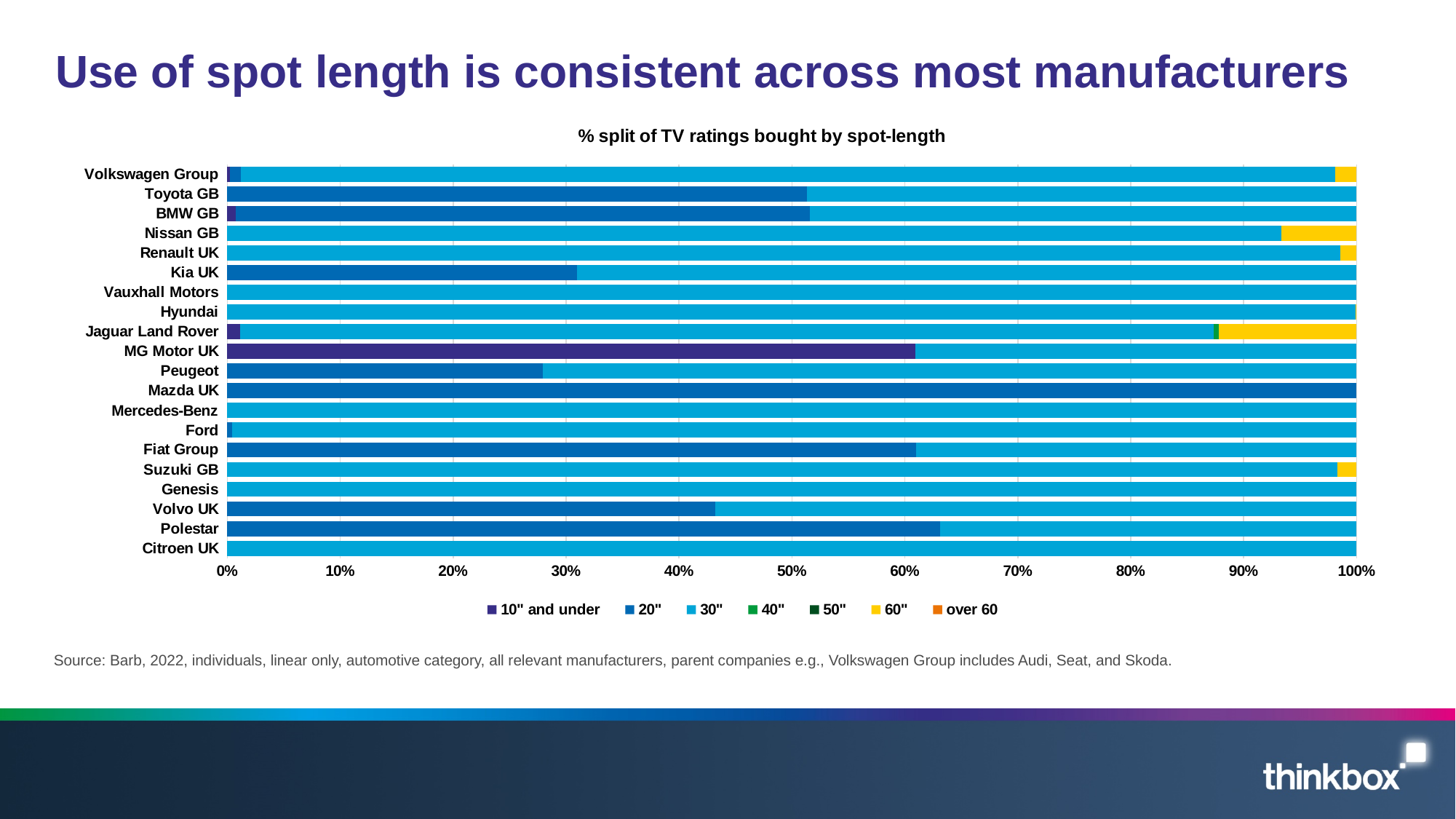
Which manufacturer has the largest share of ratings in the 60" spot length? Jaguar Land Rover What is the title of the chart? % split of TV ratings bought by spot-length Is the 20" share for Volvo UK greater or less than 50%? less What share of Mazda UK's TV ratings was bought at 20" spot length? 100% Which manufacturer has the largest share of ratings in the 10" and under spot length? MG Motor UK What kind of chart is shown on the slide? Stacked bar chart What share of Citroen UK's TV ratings was bought at 30" spot length? 100% Which has the larger 20" share, Polestar or Volvo UK? Polestar Is the 20" share for Kia UK greater or less than 40%? less Is the 10" and under share for MG Motor UK greater or less than 50%? greater How many manufacturers are listed on the chart? 20 How many spot-length series does the legend list? 7